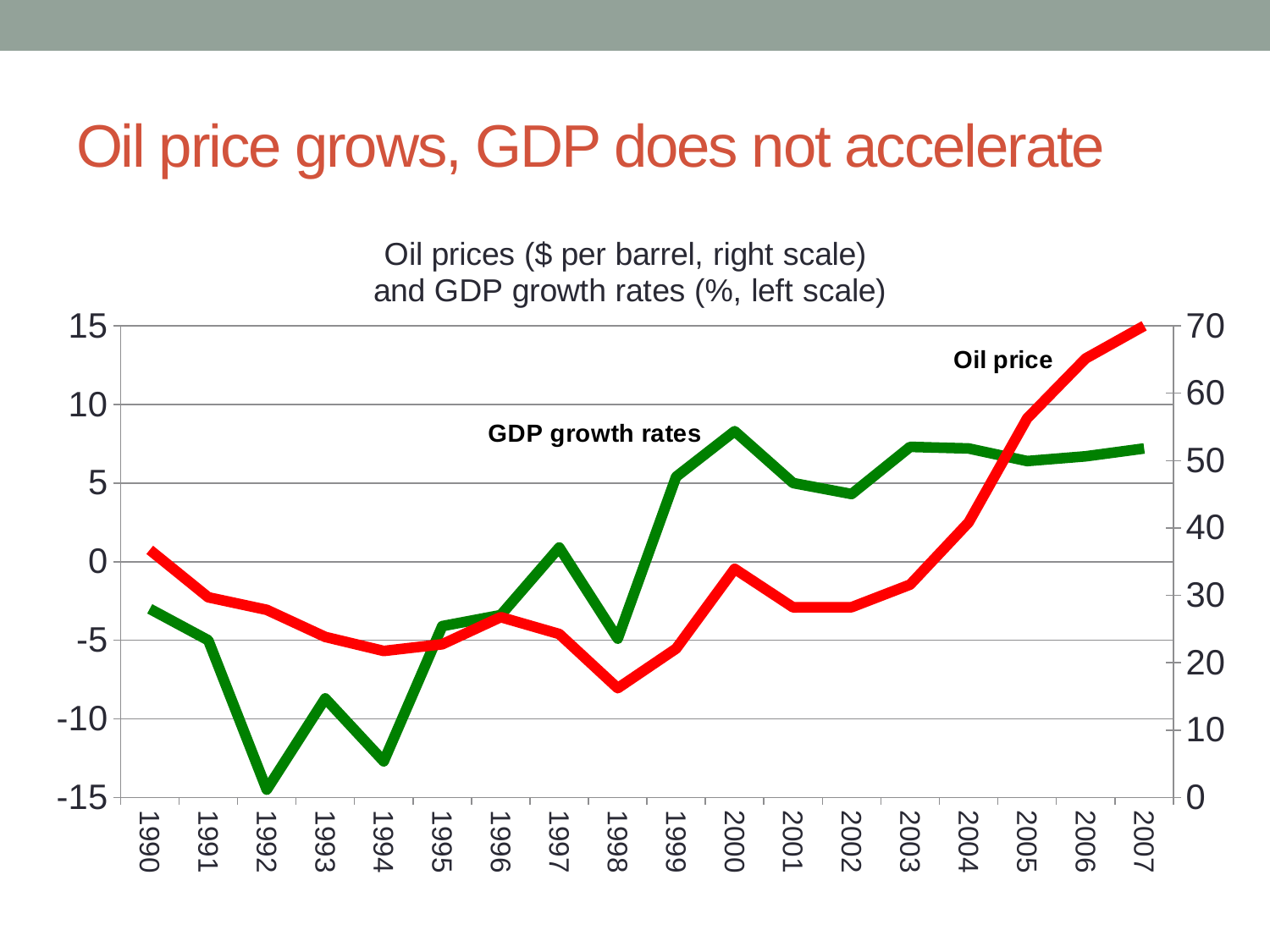
How many years are shown along the x axis of the chart? 18 Which scale is used for the oil price series, the left or the right? right scale What kind of chart is shown on the slide? line chart In which year is the oil price at its highest? 2007 In which year is the GDP growth rate at its highest? 2000 In which year is the oil price at its lowest? 1998 In which year is the GDP growth rate at its lowest? 1992 Is the oil price for 1998 greater or less than 20? less Does the oil price rise or fall from 2003 to 2007? rise Is the oil price for 2007 greater or less than 60? greater How many series are plotted on the chart? 2 Is the GDP growth rate for 1992 greater or less than -10? less